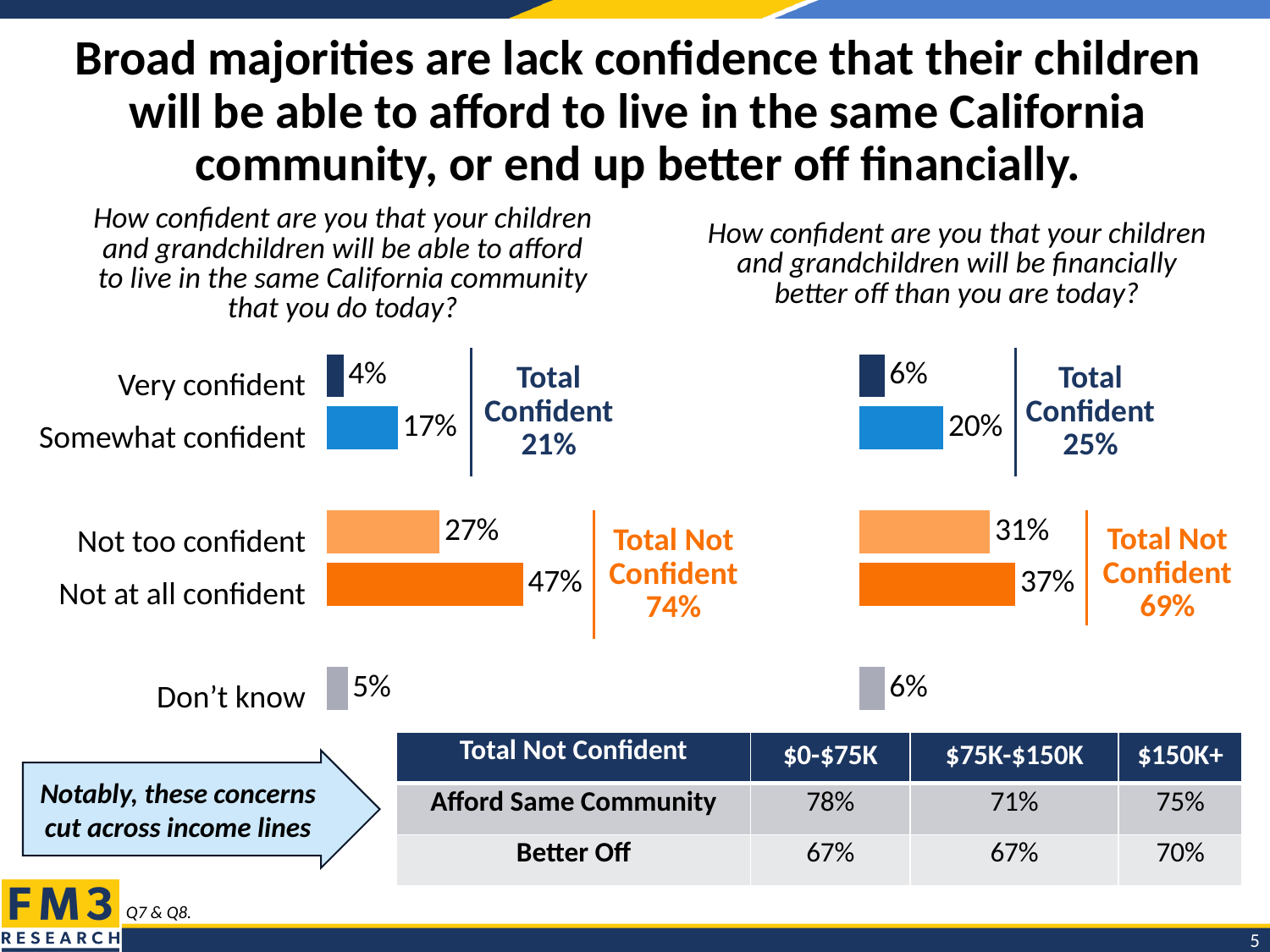
In the right chart (financially better off), which category has the highest value? Not at all confident In the left chart (afford to live in the same California community), which category has the lowest value? Very confident In the left chart (afford to live in the same California community), what is the difference between 'Not at all confident' and 'Somewhat confident'? 30% In the left chart (afford to live in the same California community), what percentage are 'Not at all confident'? 47% In the right chart (financially better off), what is the 'Total Not Confident' figure shown? 69% In the left chart (afford to live in the same California community), what is the 'Total Confident' figure shown? 21% In the right chart (financially better off), what percentage are 'Somewhat confident'? 20% In the right chart (financially better off), what is the difference between 'Not at all confident' and 'Not too confident'? 6% In the left chart (afford to live in the same California community), which category has the highest value? Not at all confident What type of chart is used on this slide? Bar chart Which is larger: 'Not too confident' in the left chart or 'Not too confident' in the right chart? Right chart (31%) How many response categories are plotted in the left chart (afford to live in the same California community)? 5